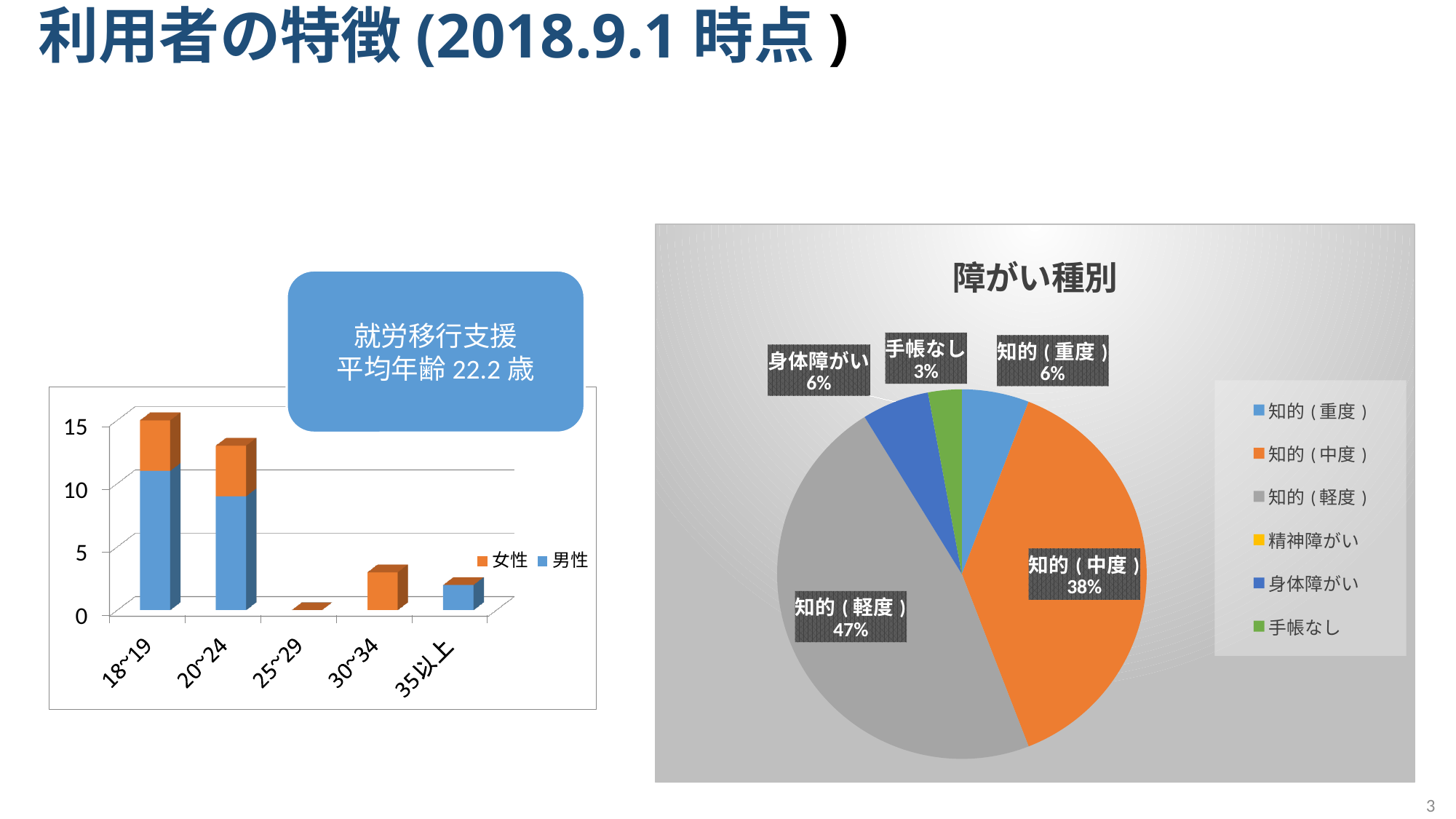
In the pie chart titled 障がい種別, what share is labelled for 知的(中度)? 38% How many age categories are shown on the x axis of the bar chart on the left? 5 In the pie chart titled 障がい種別, which category has the largest slice? 知的(軽度) What kind of chart is the chart on the left of the slide? Bar chart How many entries does the legend of the pie chart titled 障がい種別 list? 6 In the bar chart on the left, which age category has the tallest bar? 18~19 In the pie chart titled 障がい種別, what share is labelled for 知的(軽度)? 47% In the pie chart titled 障がい種別, what share is labelled for 手帳なし? 3% In the pie chart titled 障がい種別, which is larger, the 知的(中度) slice or the 知的(重度) slice? 知的(中度) In the bar chart on the left, which two series does the legend list? 女性 and 男性 In the pie chart titled 障がい種別, what is the difference in percentage points between the 知的(軽度) and 知的(中度) slices? 9 percentage points In the bar chart on the left, is the total value for 18~19 greater or less than 10? greater